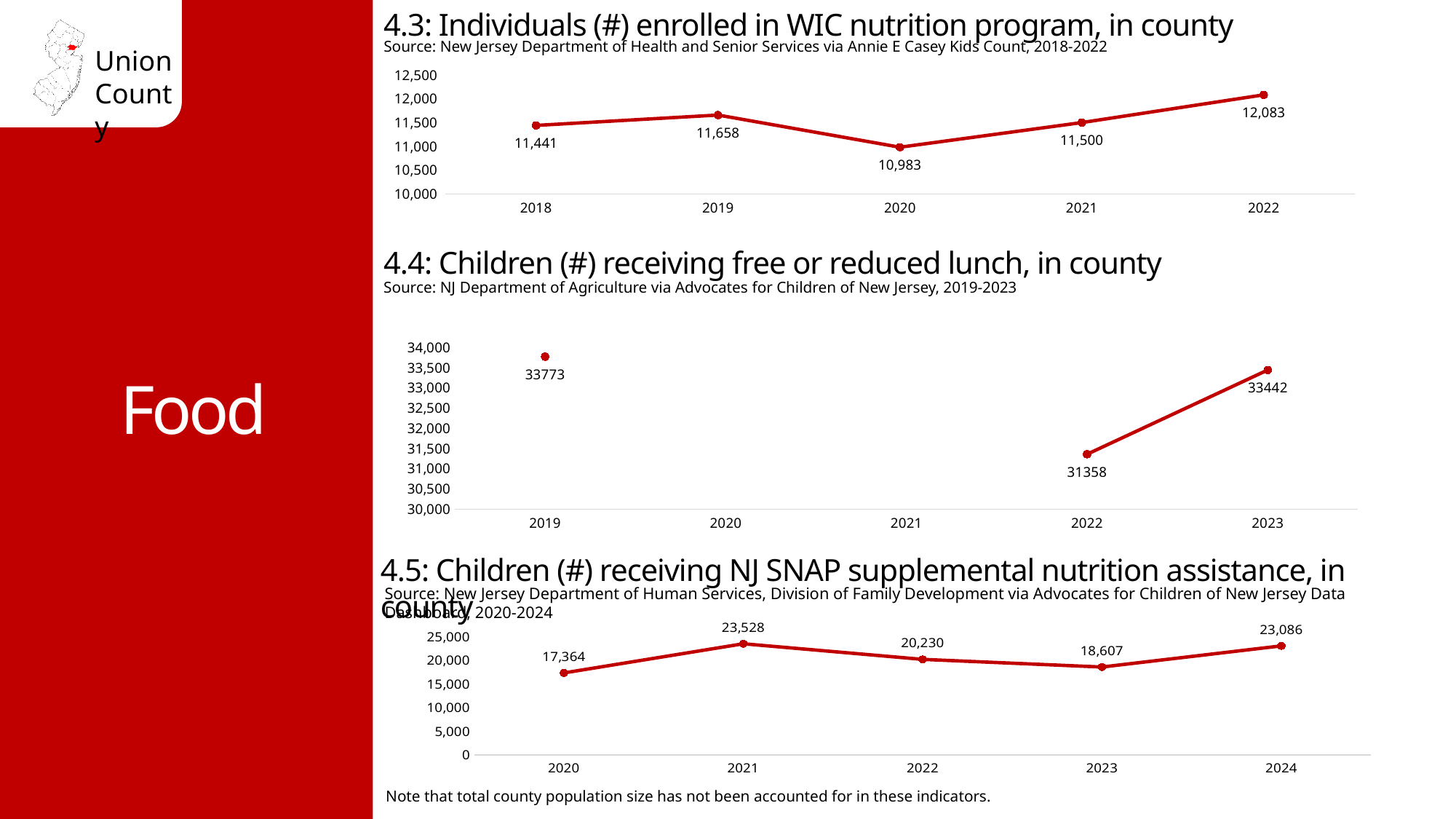
In the chart '4.5: Children (#) receiving NJ SNAP supplemental nutrition assistance, in county', what is the difference between the 2021 and 2023 values? 4,921 In the chart '4.3: Individuals (#) enrolled in WIC nutrition program, in county', what is the value for 2020? 10,983 In the chart '4.4: Children (#) receiving free or reduced lunch, in county', what is the value for 2022? 31358 In the chart '4.5: Children (#) receiving NJ SNAP supplemental nutrition assistance, in county', what is the value for 2021? 23,528 In the chart '4.3: Individuals (#) enrolled in WIC nutrition program, in county', which year has the highest value? 2022 What kind of chart is '4.5: Children (#) receiving NJ SNAP supplemental nutrition assistance, in county'? Line chart In the chart '4.4: Children (#) receiving free or reduced lunch, in county', how many data points are plotted? 3 In the chart '4.5: Children (#) receiving NJ SNAP supplemental nutrition assistance, in county', which year has the lowest value? 2020 In the chart '4.3: Individuals (#) enrolled in WIC nutrition program, in county', what is the difference between the 2022 and 2018 values? 642 In the chart '4.4: Children (#) receiving free or reduced lunch, in county', which is larger, the value for 2019 or the value for 2023? 2019 In the chart '4.3: Individuals (#) enrolled in WIC nutrition program, in county', how many years are plotted? 5 In the chart '4.4: Children (#) receiving free or reduced lunch, in county', which year has the lowest value? 2022